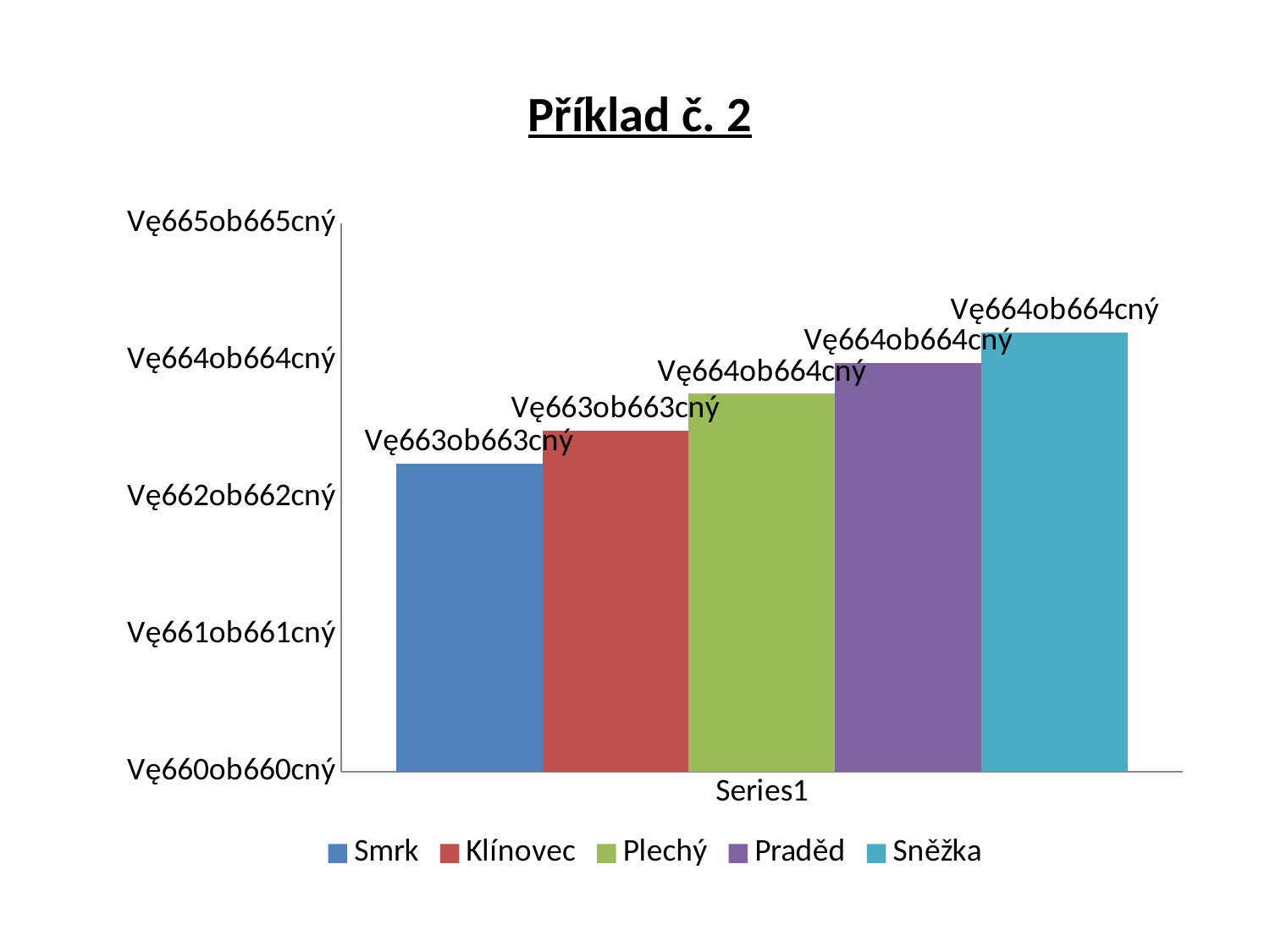
What kind of chart is shown on the slide? bar chart Which bar is taller, Sněžka or Smrk? Sněžka What is the title of the chart? Příklad č. 2 Which bar is taller, Praděd or Klínovec? Praděd How many bars are plotted in the chart? 5 What is the data label printed above the Sněžka bar? Vę664ob664cný Which legend entry has the shortest bar? Smrk What is the data label printed above the Smrk bar? Vę663ob663cný Do the bars rise or fall from left to right? rise How many entries does the legend list? 5 Which legend entry has the tallest bar? Sněžka What label is shown on the horizontal axis below the bars? Series1